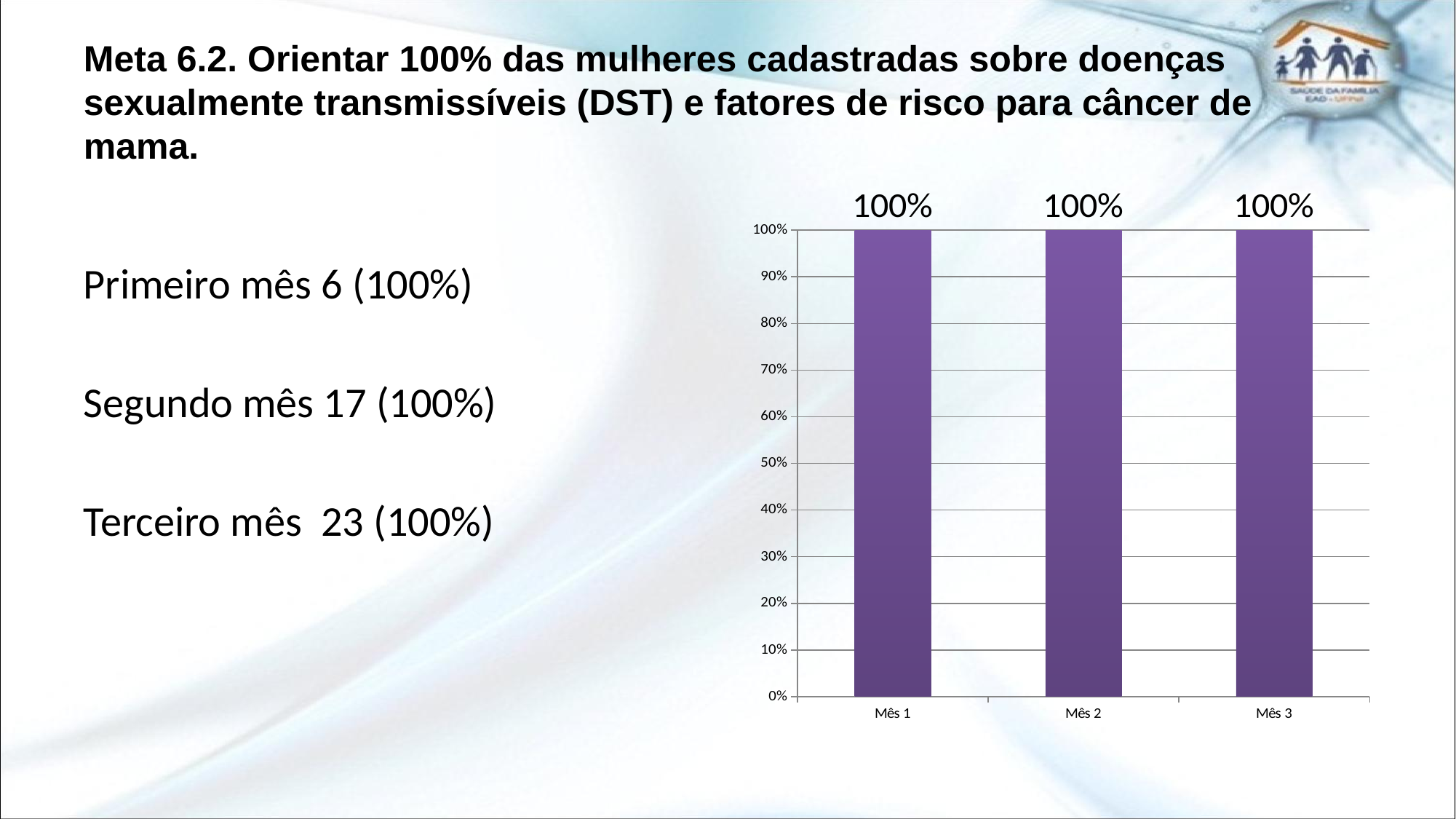
What is the value for Mês 3 in the bar chart? 100% Do the values rise, fall or stay the same from Mês 1 to Mês 3? stay the same Is the value for Mês 2 greater or less than 90%? greater What is the value for Mês 1 in the bar chart? 100% What is the value for Mês 2 in the bar chart? 100% Is the value for Mês 1 greater or less than 50%? greater What is the difference between the values for Mês 1 and Mês 3? 0% What colour are the bars in the chart? purple What kind of chart is shown on the slide? bar chart How many categories are plotted in the bar chart? 3 What is the difference between the values for Mês 2 and Mês 3? 0% What is the label of the first category on the x axis of the bar chart? Mês 1